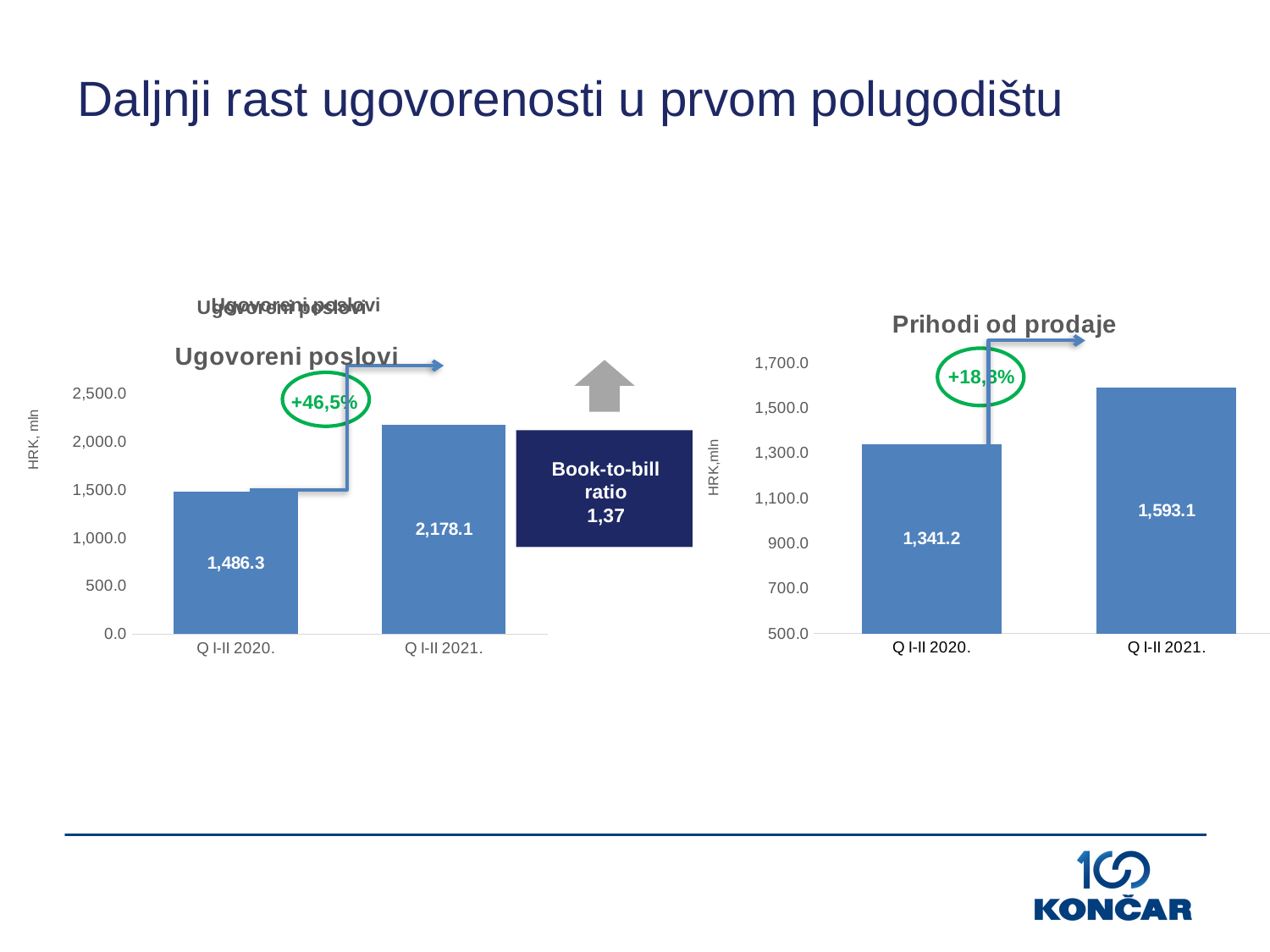
In the 'Ugovoreni poslovi' chart, what is the difference between the Q I-II 2021. and Q I-II 2020. values? 691.8 How many bars are plotted in the 'Prihodi od prodaje' chart? 2 In the 'Ugovoreni poslovi' chart, is the value for Q I-II 2021. greater or less than 2,000.0? greater In the 'Prihodi od prodaje' chart, what is the value for Q I-II 2020.? 1,341.2 In the 'Prihodi od prodaje' chart, what is the difference between the Q I-II 2021. and Q I-II 2020. values? 251.9 In the 'Ugovoreni poslovi' chart, which period has the higher value? Q I-II 2021. In the 'Prihodi od prodaje' chart, what is the value for Q I-II 2021.? 1,593.1 What is the Book-to-bill ratio shown between the two charts? 1,37 In the 'Prihodi od prodaje' chart, which period has the lower value? Q I-II 2020. What type of chart is the 'Prihodi od prodaje' chart? bar chart In the 'Ugovoreni poslovi' chart, what is the value for Q I-II 2021.? 2,178.1 In the 'Ugovoreni poslovi' chart, what is the value for Q I-II 2020.? 1,486.3